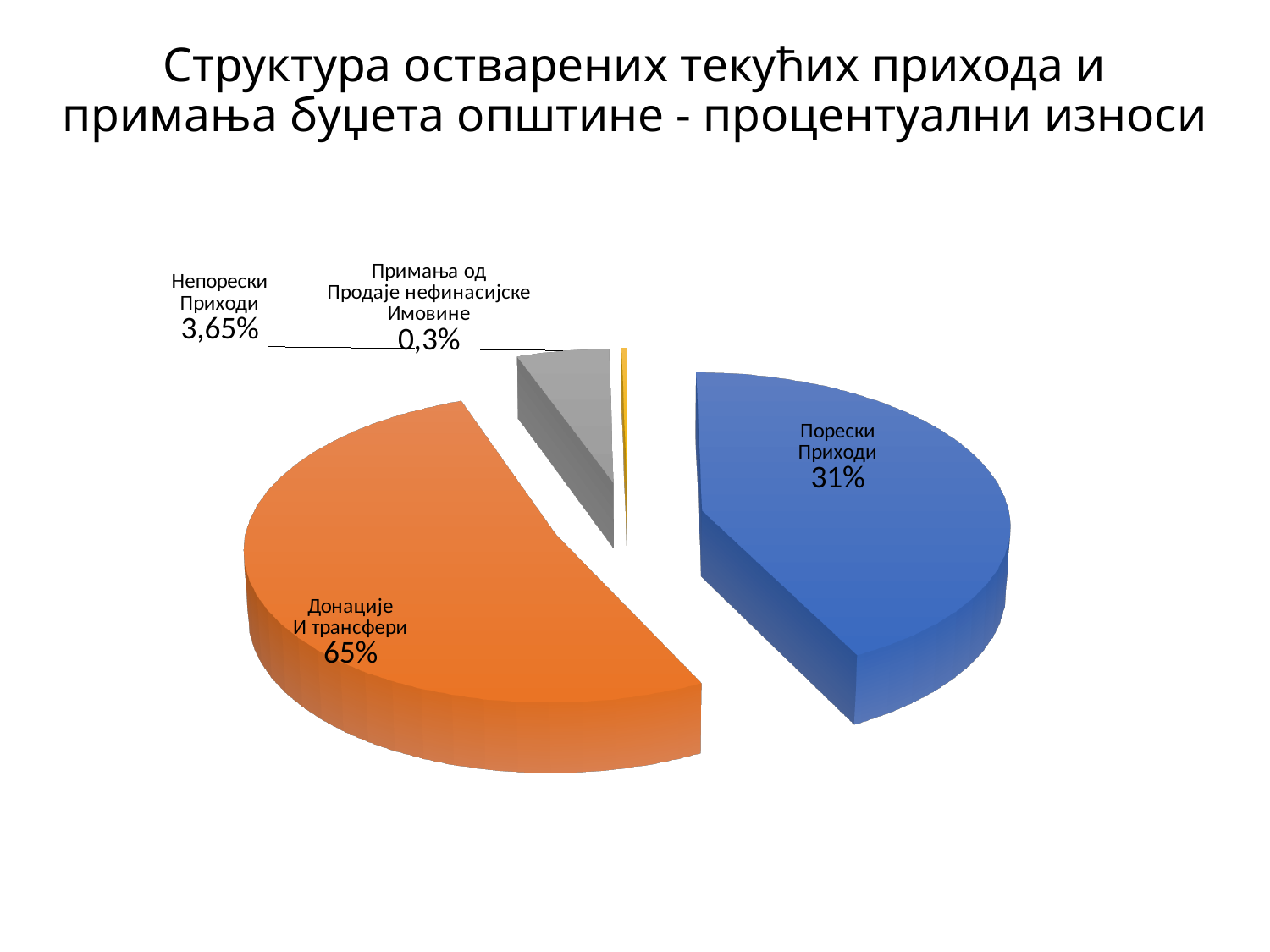
What percentage is shown for Порески Приходи? 31% What percentage is shown for Непорески Приходи? 3,65% What type of chart is shown on the slide? Pie chart Which category has the largest slice of the pie? Донације И трансфери Which category has the smallest slice of the pie? Примања од Продаје нефинасијске Имовине How many slices does the pie chart have? 4 What is the difference in percentage points between Донације И трансфери and Порески Приходи? 34% What percentage is shown for Примања од Продаје нефинасијске Имовине? 0,3% What percentage is shown for Донације И трансфери? 65% Which is larger, Порески Приходи or Непорески Приходи? Порески Приходи What is the difference in percentage points between Непорески Приходи and Примања од Продаје нефинасијске Имовине? 3,35% What colour is the slice for Порески Приходи? Blue